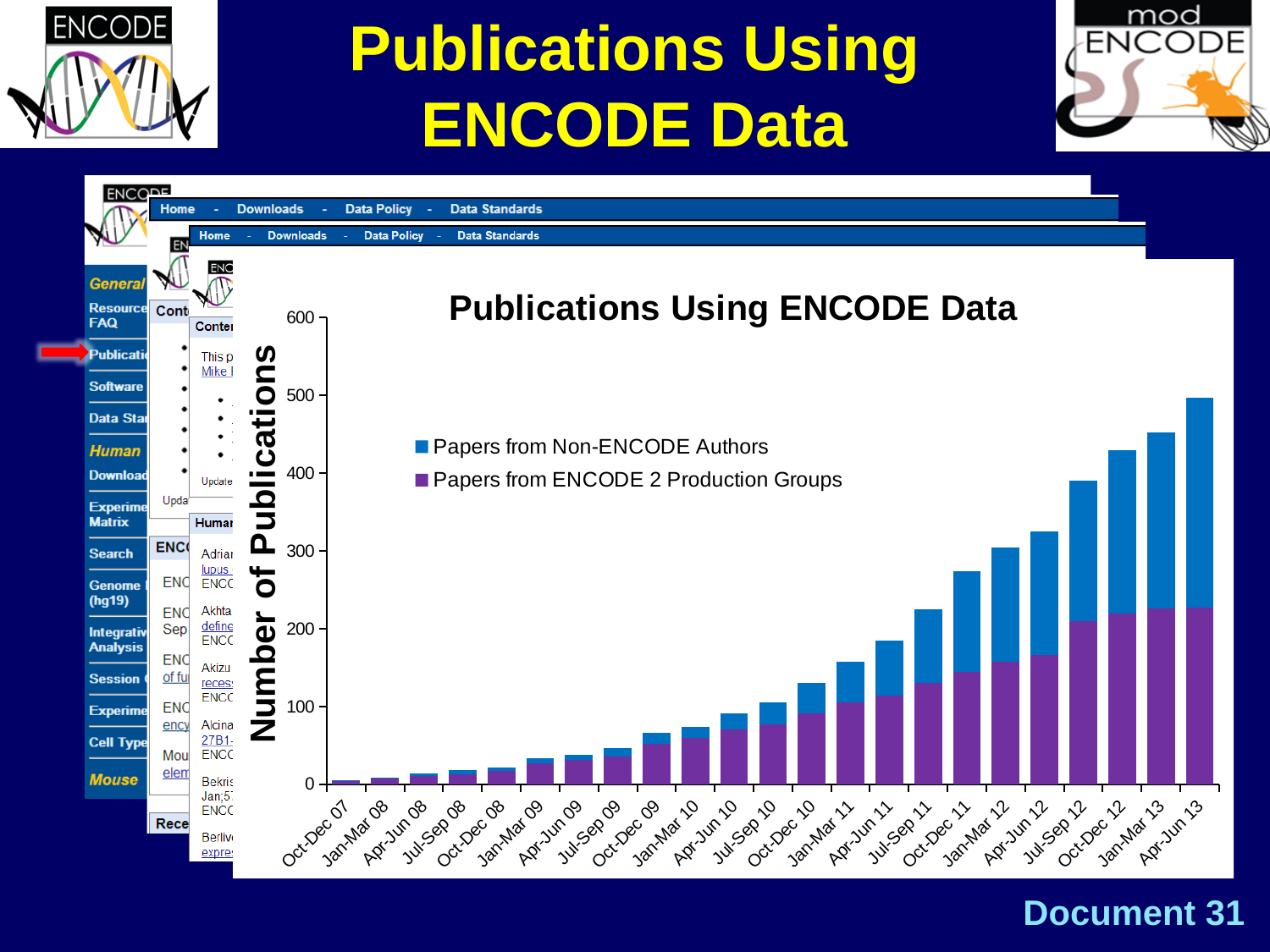
Do the total number of publications rise or fall from Oct-Dec 07 to Apr-Jun 13? Rise Which time period has the lowest total number of publications? Oct-Dec 07 What type of chart is shown on the slide? Stacked bar chart How many series does the chart's legend list? 2 Is the total number of publications for Oct-Dec 12 greater or less than 400? greater How many time periods (categories) are shown on the x axis of the chart? 23 Is the total number of publications for Oct-Dec 11 greater or less than 300? less Which has a larger total number of publications, Jan-Mar 10 or Jan-Mar 12? Jan-Mar 12 Which time period has the highest total number of publications? Apr-Jun 13 What is the title of the chart? Publications Using ENCODE Data Is the total number of publications for Apr-Jun 13 greater or less than 400? greater What is the label of the y axis of the chart? Number of Publications